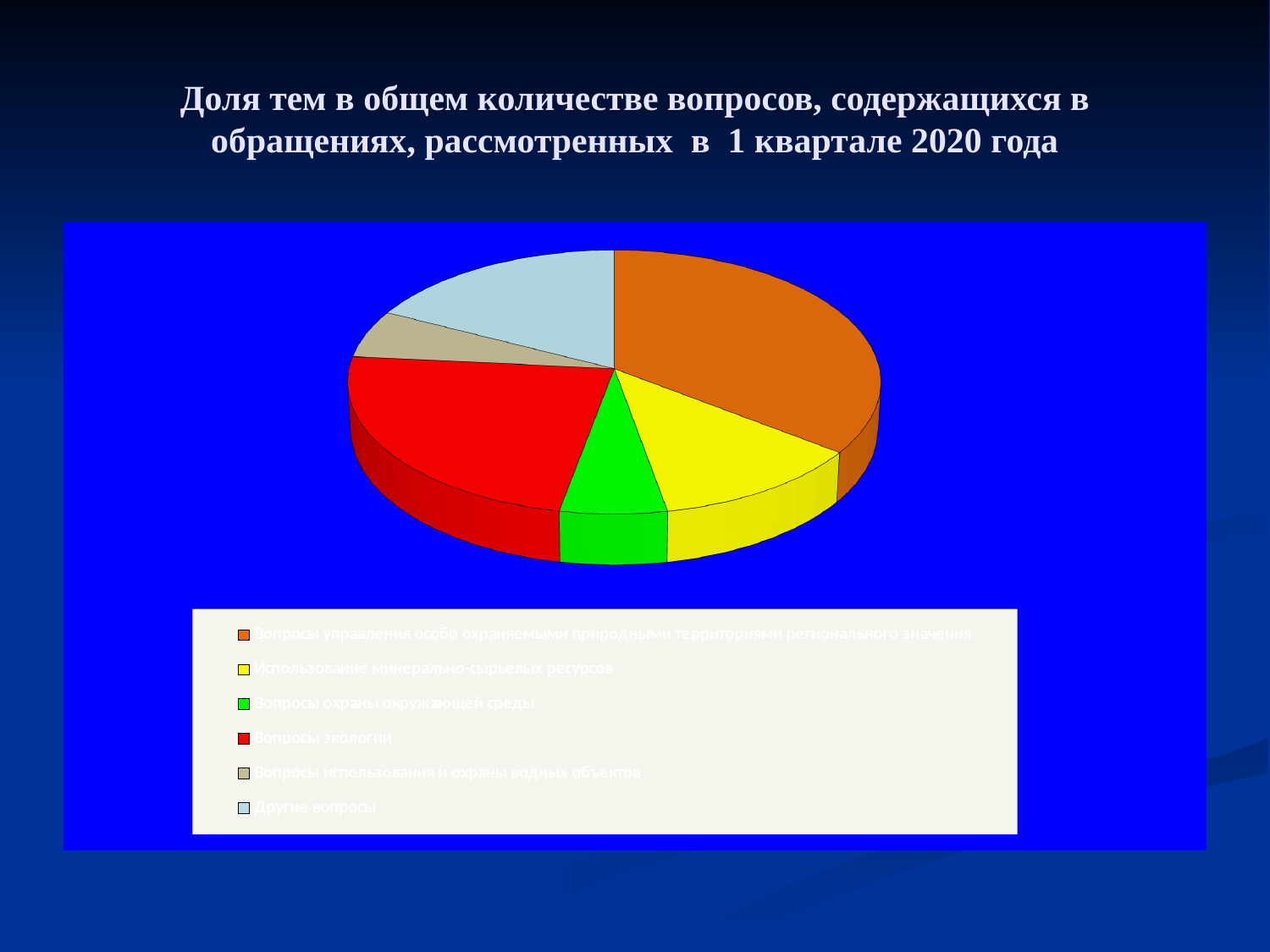
How many slices does the pie chart have? 6 Which slice is larger: "Вопросы экологии" or "Другие вопросы"? Вопросы экологии Which slice is larger: "Другие вопросы" or "Вопросы использования и охраны водных объектов"? Другие вопросы Which category is shown in yellow in the pie chart? Использование минерально-сырьевых ресурсов Which slice is larger: "Вопросы управления особо охраняемыми природными территориями регионального значения" or "Использование минерально-сырьевых ресурсов"? Вопросы управления особо охраняемыми природными территориями регионального значения What colour is the slice for "Вопросы экологии" in the pie chart? Red Which category has the largest slice of the pie chart? Вопросы управления особо охраняемыми природными территориями регионального значения How many entries does the legend of the pie chart list? 6 What kind of chart is shown on the slide? Pie chart